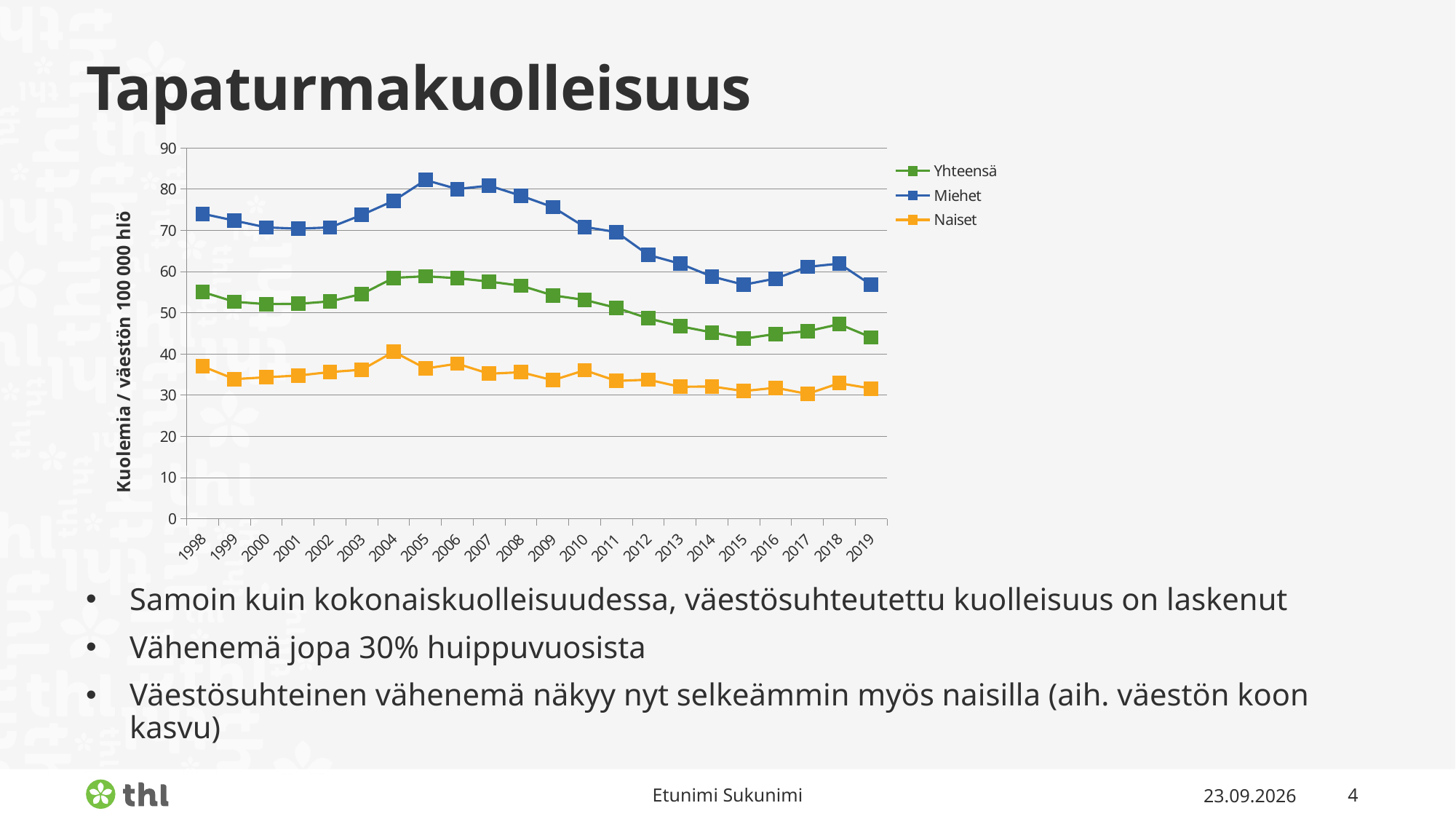
In which year does the Miehet series reach its highest value? 2005 In which year does the Naiset series reach its highest value? 2004 Is the value for Miehet in 2019 greater or less than 60? less Does the Miehet series rise or fall between 2005 and 2015? fall What is the title of the vertical axis? Kuolemia / väestön 100 000 hlö What kind of chart is shown on the slide? line chart Is the value for Miehet in 2005 greater or less than 80? greater Which series has the larger value in 2010, Miehet or Naiset? Miehet Is the value for Yhteensä in 2019 greater or less than 50? less How many series does the legend list? 3 How many years are plotted along the x axis? 22